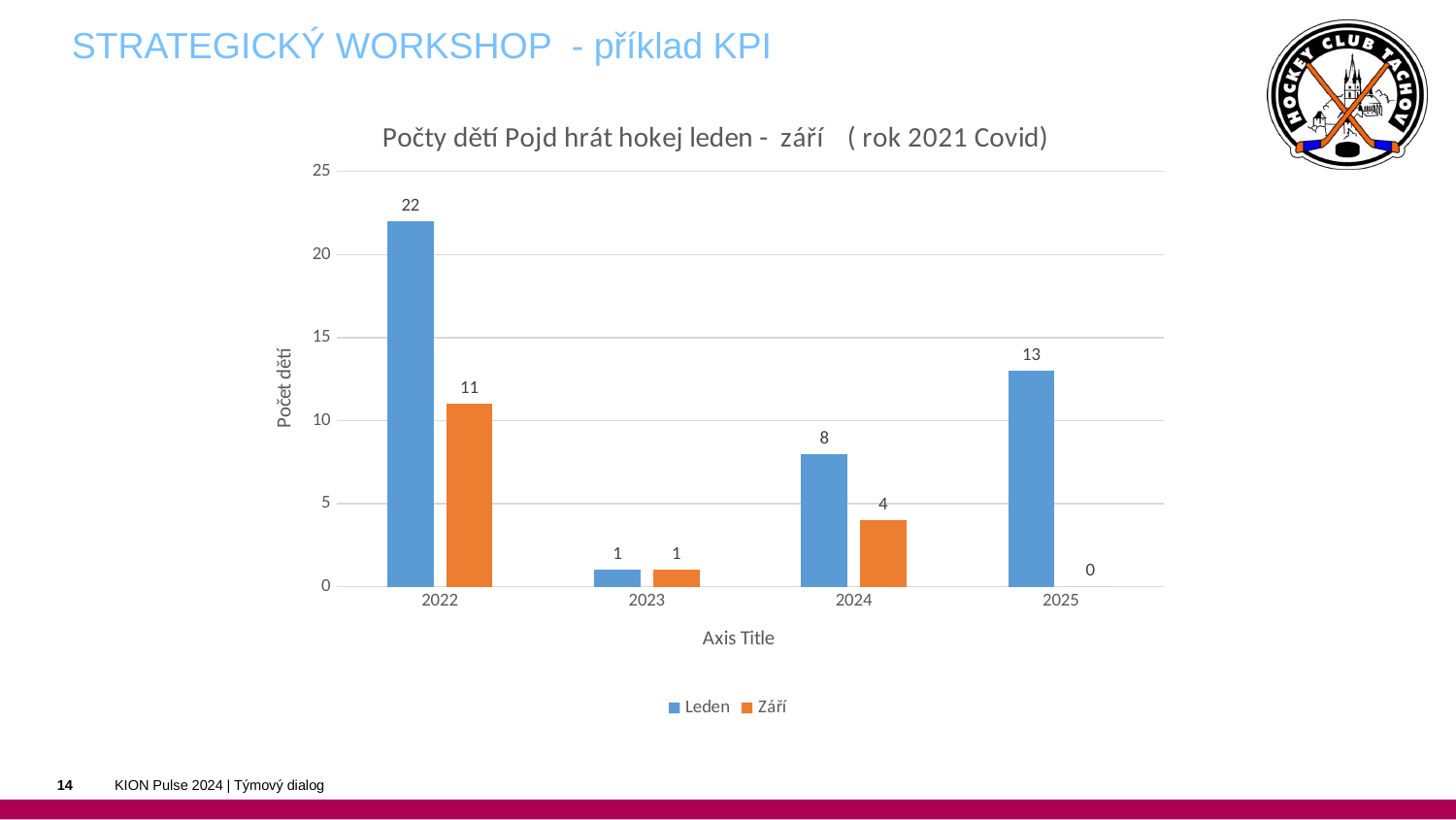
Which is larger in 2024, the Leden value or the Září value? Leden How many series does the legend list? 2 Which year has the lowest value for Leden? 2023 How many years are shown on the x axis? 4 What is the value for Září in 2024? 4 Which year has the highest value for Leden? 2022 What kind of chart is shown on the slide? Bar chart What is the value for Leden in 2022? 22 What is the value for Září in 2025? 0 What is the label of the vertical axis? Počet dětí Which colour represents the Září series? Orange What is the difference between the Leden and Září values in 2022? 11